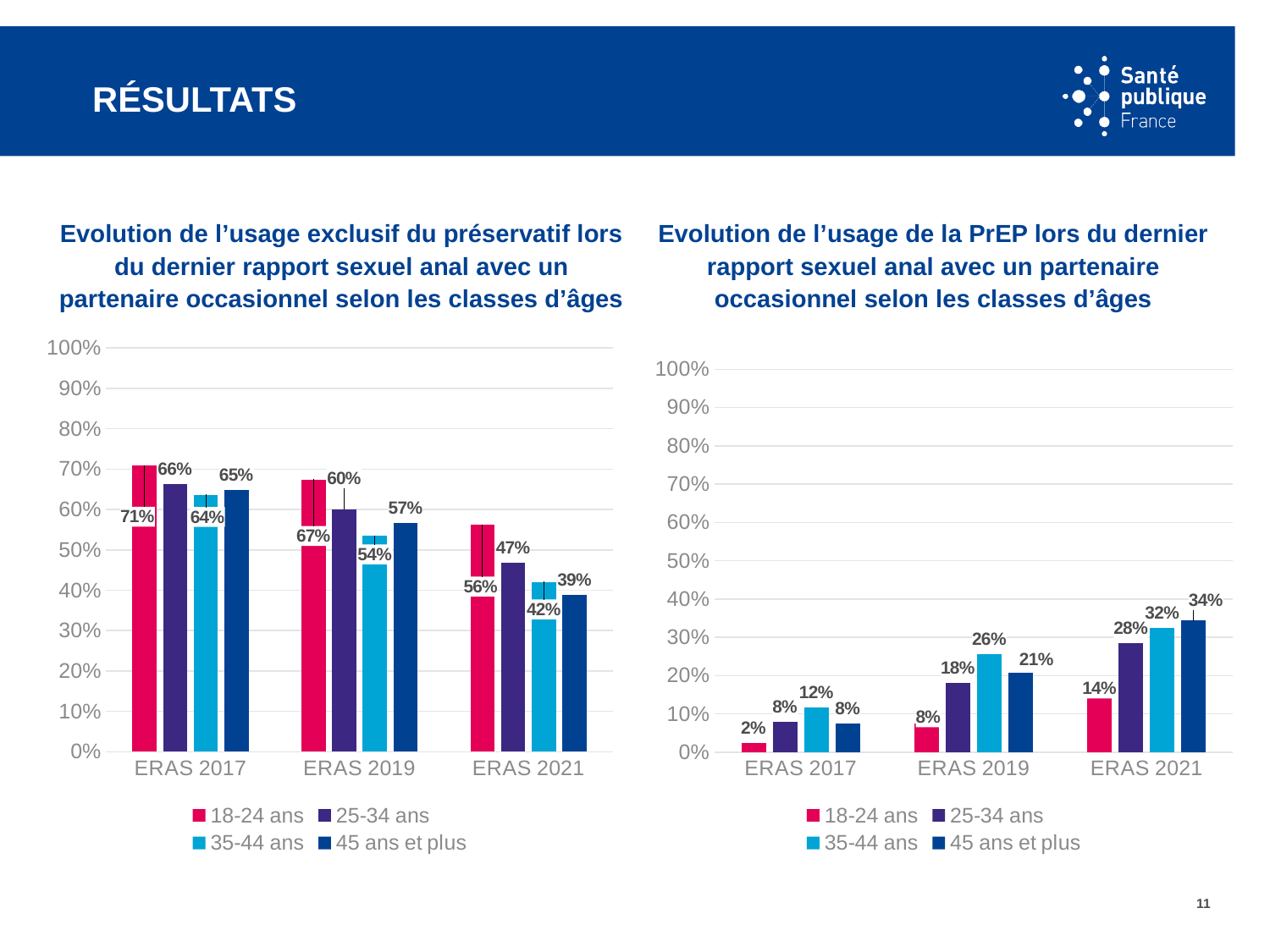
In the left chart (usage exclusif du préservatif), which age group has the lowest value in ERAS 2021? 45 ans et plus How many series does the legend of the right chart (usage de la PrEP) list? 4 In the right chart (usage de la PrEP), what is the value for 35-44 ans in ERAS 2019? 26% In the left chart (usage exclusif du préservatif), what is the difference between the 18-24 ans values for ERAS 2017 and ERAS 2021? 15 percentage points In the right chart (usage de la PrEP), which age group has the highest value in ERAS 2021? 45 ans et plus What type of chart is the left chart (usage exclusif du préservatif)? Bar chart In the left chart (usage exclusif du préservatif), does the value for 18-24 ans rise or fall from ERAS 2017 to ERAS 2021? Fall In the right chart (usage de la PrEP), what is the difference between the 45 ans et plus values for ERAS 2021 and ERAS 2017? 26 percentage points In the left chart (usage exclusif du préservatif), what is the value for 18-24 ans in ERAS 2017? 71% In the right chart (usage de la PrEP), which is larger: the value for 25-34 ans in ERAS 2021 or the value for 35-44 ans in ERAS 2019? 25-34 ans in ERAS 2021 In the left chart (usage exclusif du préservatif), what is the value for 35-44 ans in ERAS 2019? 54% In the right chart (usage de la PrEP), what is the value for 18-24 ans in ERAS 2017? 2%